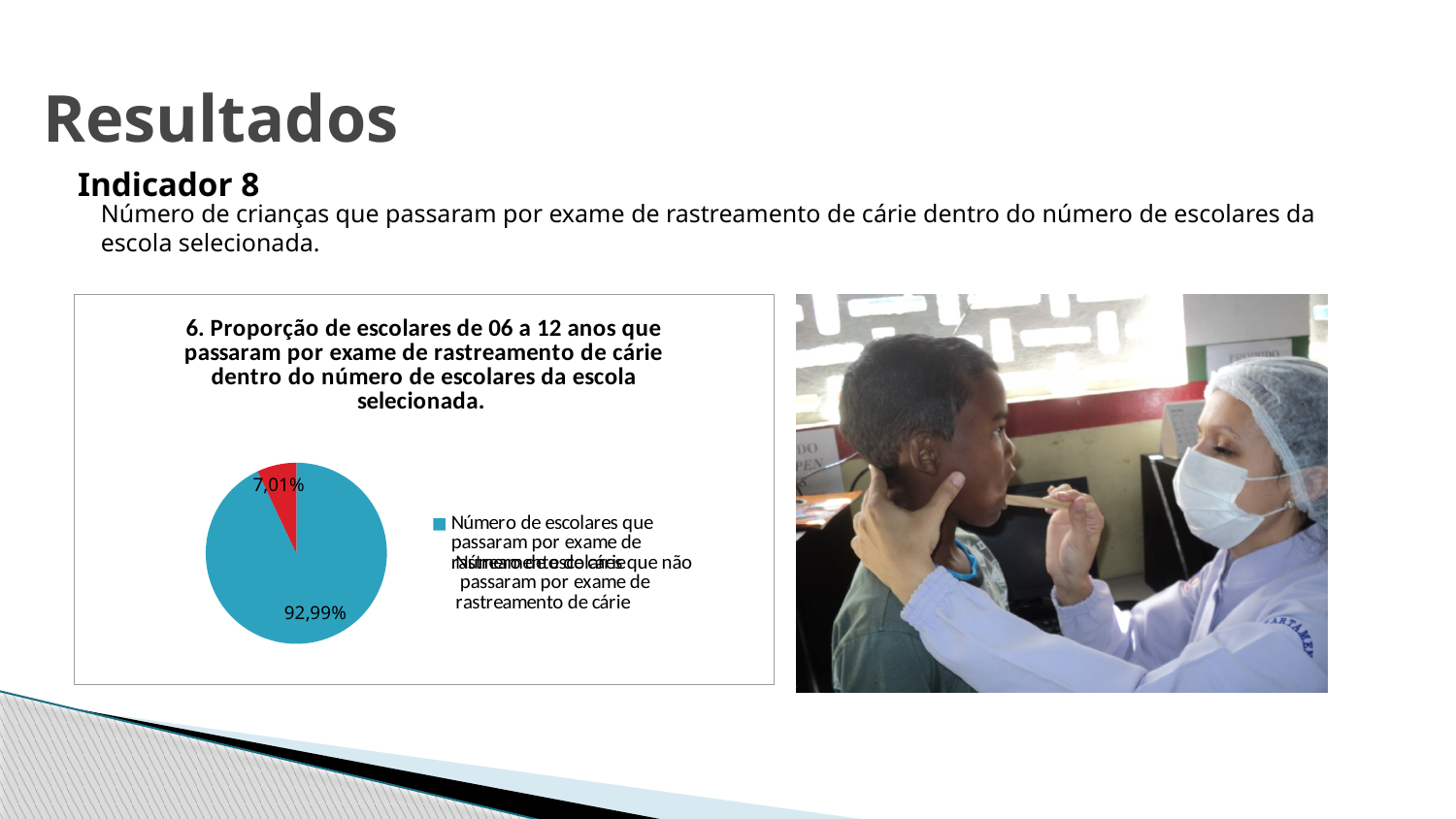
What is the value of the smallest slice of the pie chart? 7,01% Which slice is larger, the blue one or the red one? the blue one Is the value of the red slice greater or less than 10%? less What is the difference between the two slice values in the pie chart? 85,98% What percentage is shown for the blue slice of the pie chart? 92,99% What kind of chart is shown on the slide? pie chart What share of the pie corresponds to the number of schoolchildren who underwent the caries screening exam (escolares que passaram por exame de rastreamento de cárie)? 92,99% How many slices does the pie chart have? 2 What is the value of the largest slice of the pie chart? 92,99% How many entries does the legend of the pie chart list? 2 What percentage is shown for the red slice of the pie chart? 7,01% What number precedes the title of the pie chart? 6